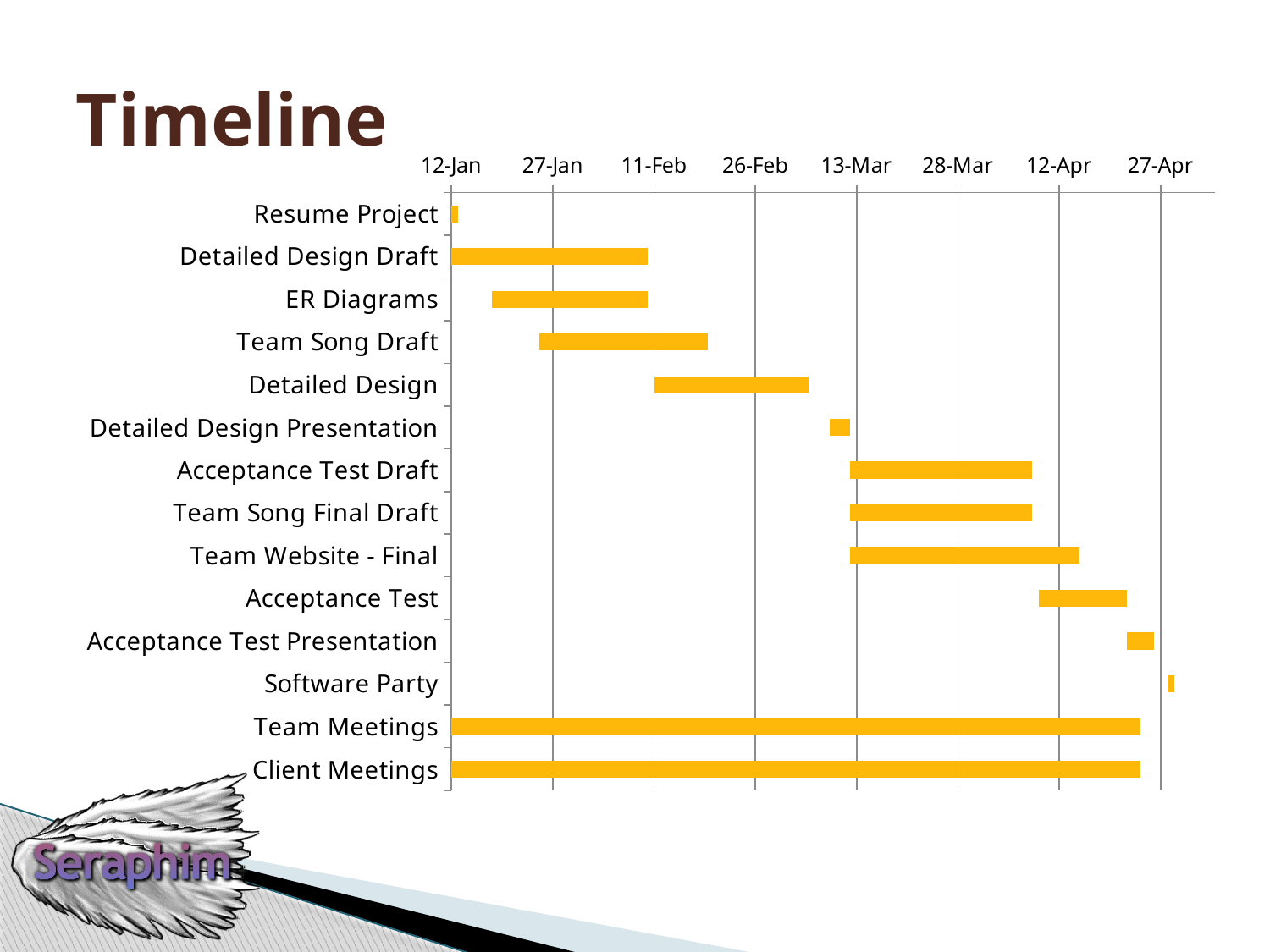
Which task is listed first (at the top) on the chart? Resume Project Which bar is longer: Detailed Design Draft or Detailed Design Presentation? Detailed Design Draft Does the Team Song Draft bar end before or after 11-Feb? after Does the Software Party bar fall before or after 27-Apr? after What is the title of the slide containing the chart? Timeline Which task is listed last (at the bottom) on the chart? Client Meetings What is the first date label shown on the horizontal axis? 12-Jan What kind of chart is shown on the slide? Bar chart (Gantt-style horizontal bars) Which task's bar starts at the 11-Feb tick? Detailed Design Does the Acceptance Test bar start before or after 12-Apr? before How many tasks are listed on the vertical axis of the chart? 14 Which bar is longer: Team Website - Final or Acceptance Test? Team Website - Final